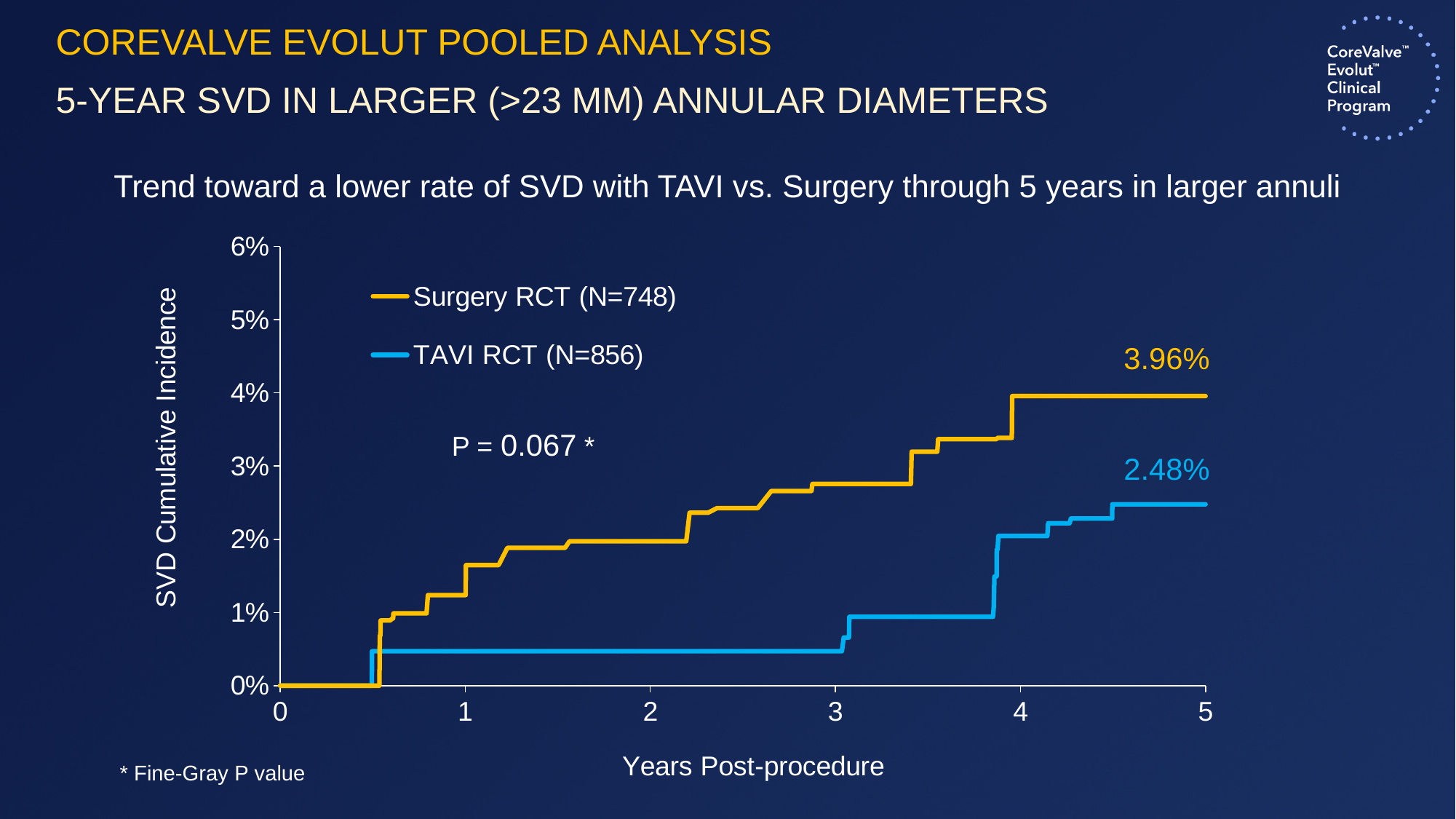
Which group has the higher SVD cumulative incidence at 5 years? Surgery RCT What is the 5-year SVD cumulative incidence for the Surgery RCT group? 3.96% Is the 5-year SVD cumulative incidence for TAVI RCT greater or less than 3%? less What kind of chart is shown on the slide? Line chart (cumulative incidence curve) Is the SVD cumulative incidence for TAVI RCT at year 2 greater or less than 1%? less Is the SVD cumulative incidence for Surgery RCT at year 3 greater or less than 2%? greater What is the 5-year SVD cumulative incidence for the TAVI RCT group? 2.48% What is the difference between the Surgery RCT and TAVI RCT 5-year SVD cumulative incidence values? 1.48% How many series does the legend list? 2 Do the SVD cumulative incidence curves rise or fall as years post-procedure increase? Rise What is the P value shown on the chart? P = 0.067 Which group has the lower SVD cumulative incidence at 5 years? TAVI RCT